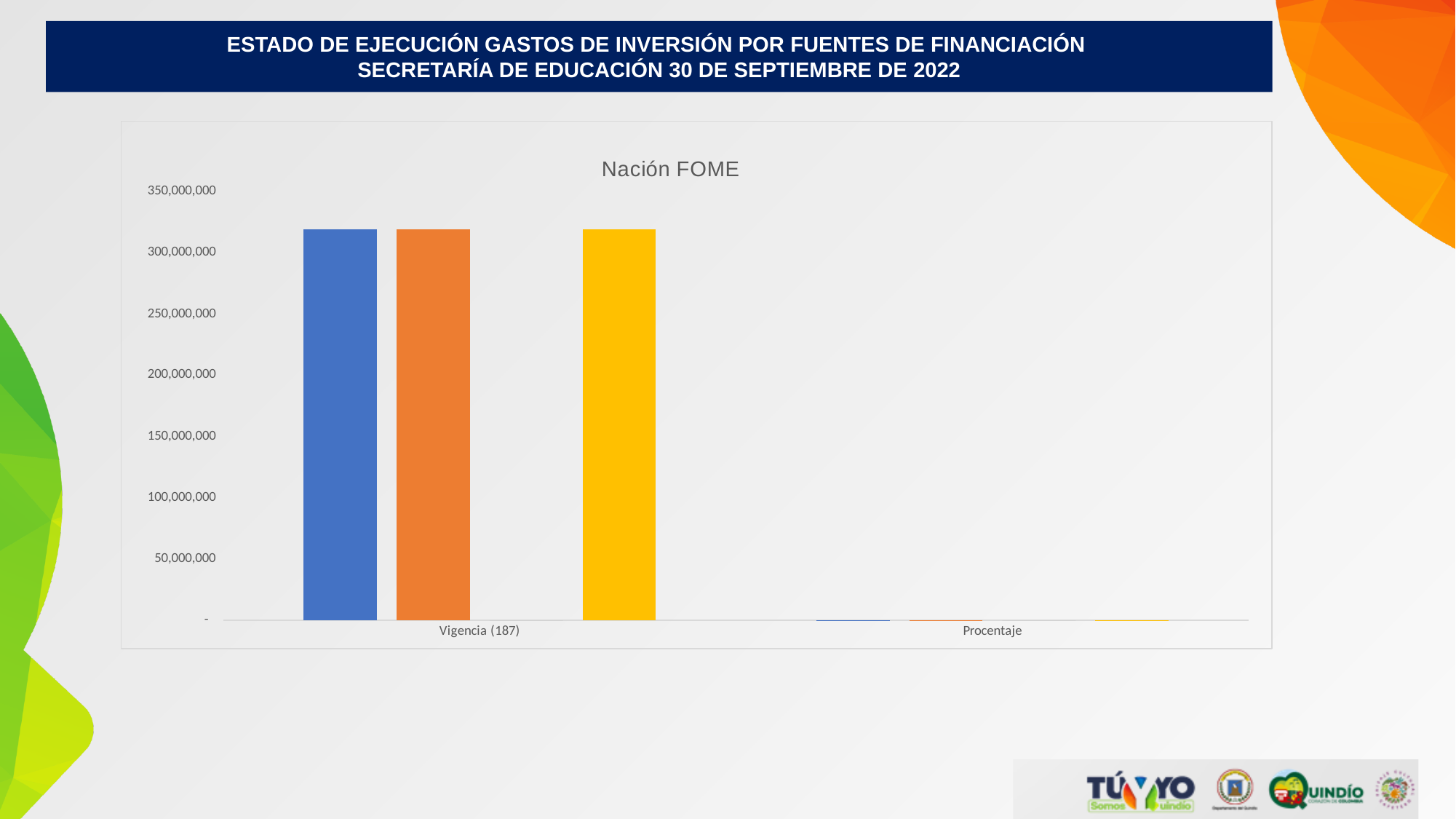
How many bars are plotted in the Vigencia (187) category? 3 What is the title of the chart? Nación FOME Is the value of the blue bar for Procentaje greater or less than 50,000,000? less Which category has the taller bars, Vigencia (187) or Procentaje? Vigencia (187) Which category has the lowest bar values in the chart? Procentaje Do the bar values rise or fall from Vigencia (187) to Procentaje? fall Is the value of the blue bar for Vigencia (187) greater or less than 300,000,000? greater Is the value of the yellow bar for Vigencia (187) greater or less than 250,000,000? greater What is the highest value shown on the vertical axis of the chart? 350,000,000 What kind of chart is shown on the slide? bar chart How many categories are shown on the x axis of the chart? 2